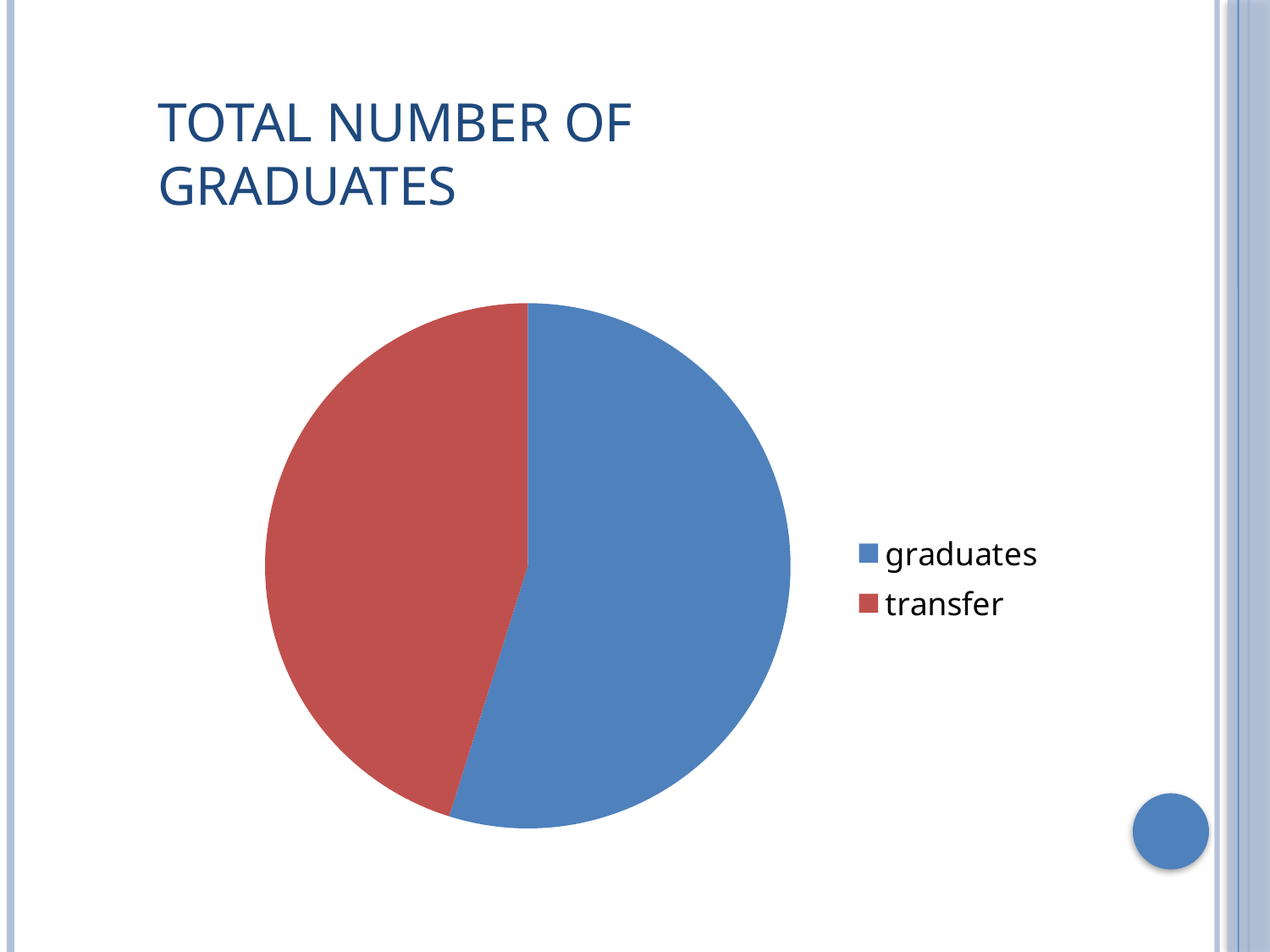
How many entries does the legend of the pie chart list? 2 How many slices does the pie chart have? 2 Which slice of the pie chart is the largest? graduates Which is larger in the pie chart, graduates or transfer? graduates What is the title of the slide containing the pie chart? TOTAL NUMBER OF GRADUATES Which slice of the pie chart is the smallest? transfer What kind of chart is shown on the slide? pie chart What colour is the transfer slice in the pie chart? red